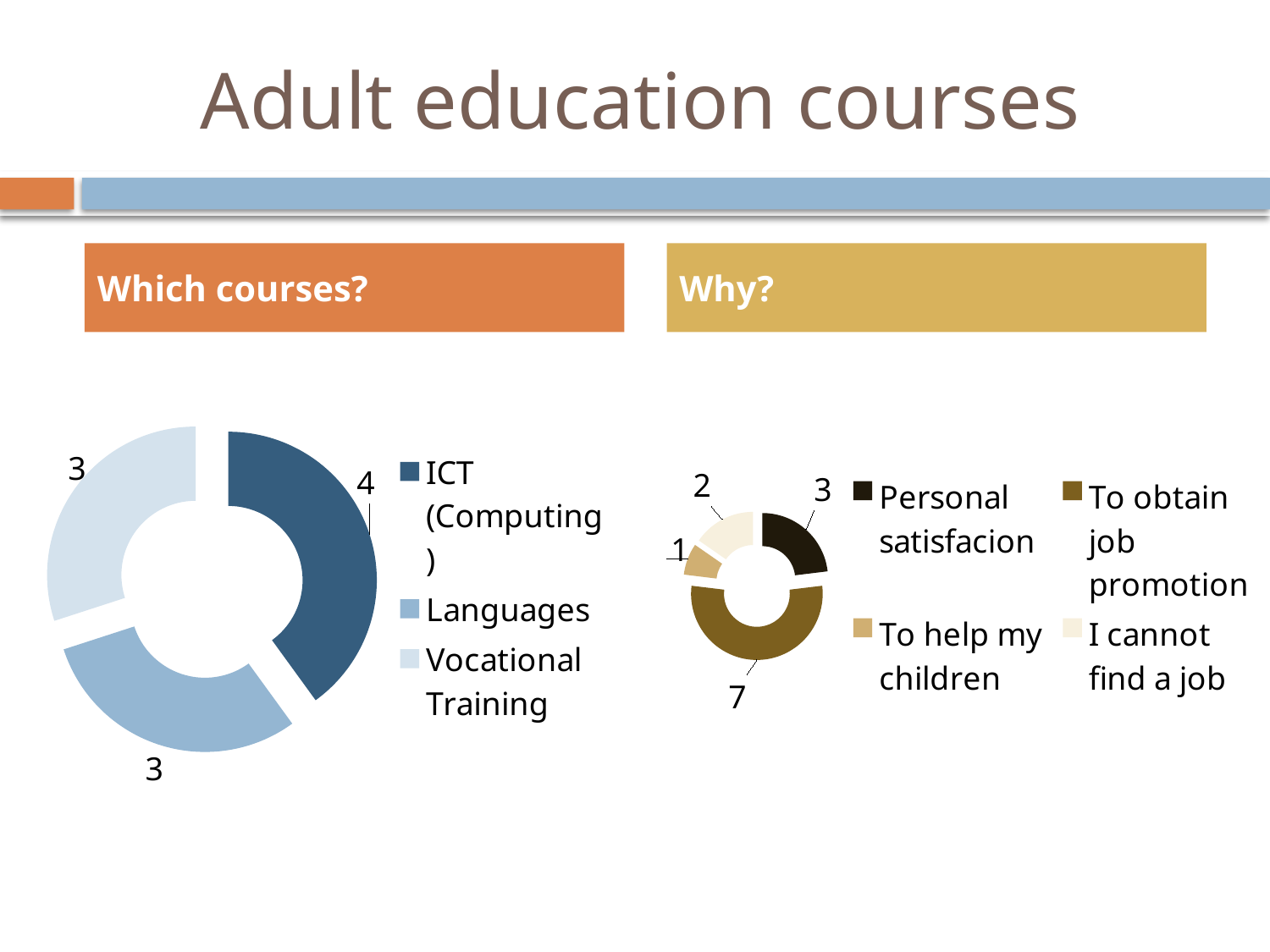
In the 'Which courses?' chart, what share of the total does ICT (Computing) represent? 40% In the 'Which courses?' chart, how many categories are shown? 3 In the 'Why?' chart, which is larger: 'I cannot find a job' or 'Personal satisfaction'? Personal satisfaction In the 'Why?' chart, which reason has the lowest value? To help my children In the 'Which courses?' chart, what is the value for ICT (Computing)? 4 In the 'Which courses?' chart, which course has the highest value? ICT (Computing) In the 'Why?' chart, what is the value for 'To obtain job promotion'? 7 In the 'Why?' chart, how many reasons does the legend list? 4 In the 'Why?' chart, what is the value for 'To help my children'? 1 In the 'Which courses?' chart, what is the value for Languages? 3 What kind of chart is the 'Which courses?' chart? doughnut chart In the 'Why?' chart, what is the difference between 'To obtain job promotion' and 'Personal satisfaction'? 4